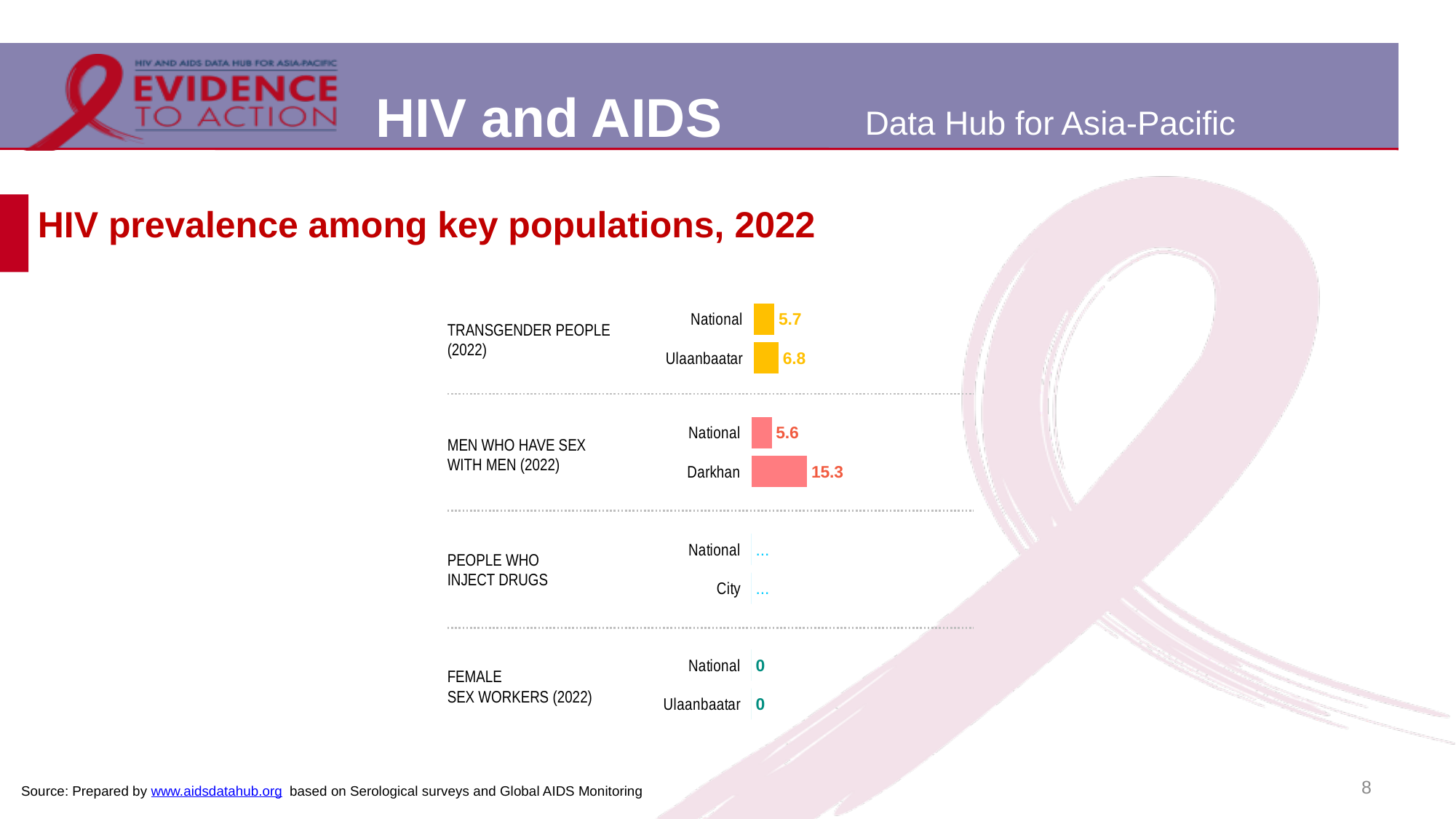
What is shown for the national HIV prevalence among people who inject drugs? … How many key population groups are shown on the chart? 4 What kind of chart is used to show HIV prevalence among key populations? Bar chart Which bar shows the highest HIV prevalence value on the chart? Men who have sex with men, Darkhan What is the national HIV prevalence among men who have sex with men (2022)? 5.6 What is the HIV prevalence among transgender people in Ulaanbaatar (2022)? 6.8 Which is larger: the national HIV prevalence among transgender people or the national HIV prevalence among men who have sex with men? Transgender people What is the difference between the Ulaanbaatar and national HIV prevalence among transgender people? 1.1 What is the difference between the Darkhan and national HIV prevalence among men who have sex with men? 9.7 What is the national HIV prevalence among transgender people (2022)? 5.7 What is the HIV prevalence among men who have sex with men in Darkhan (2022)? 15.3 What is the national HIV prevalence among female sex workers (2022)? 0